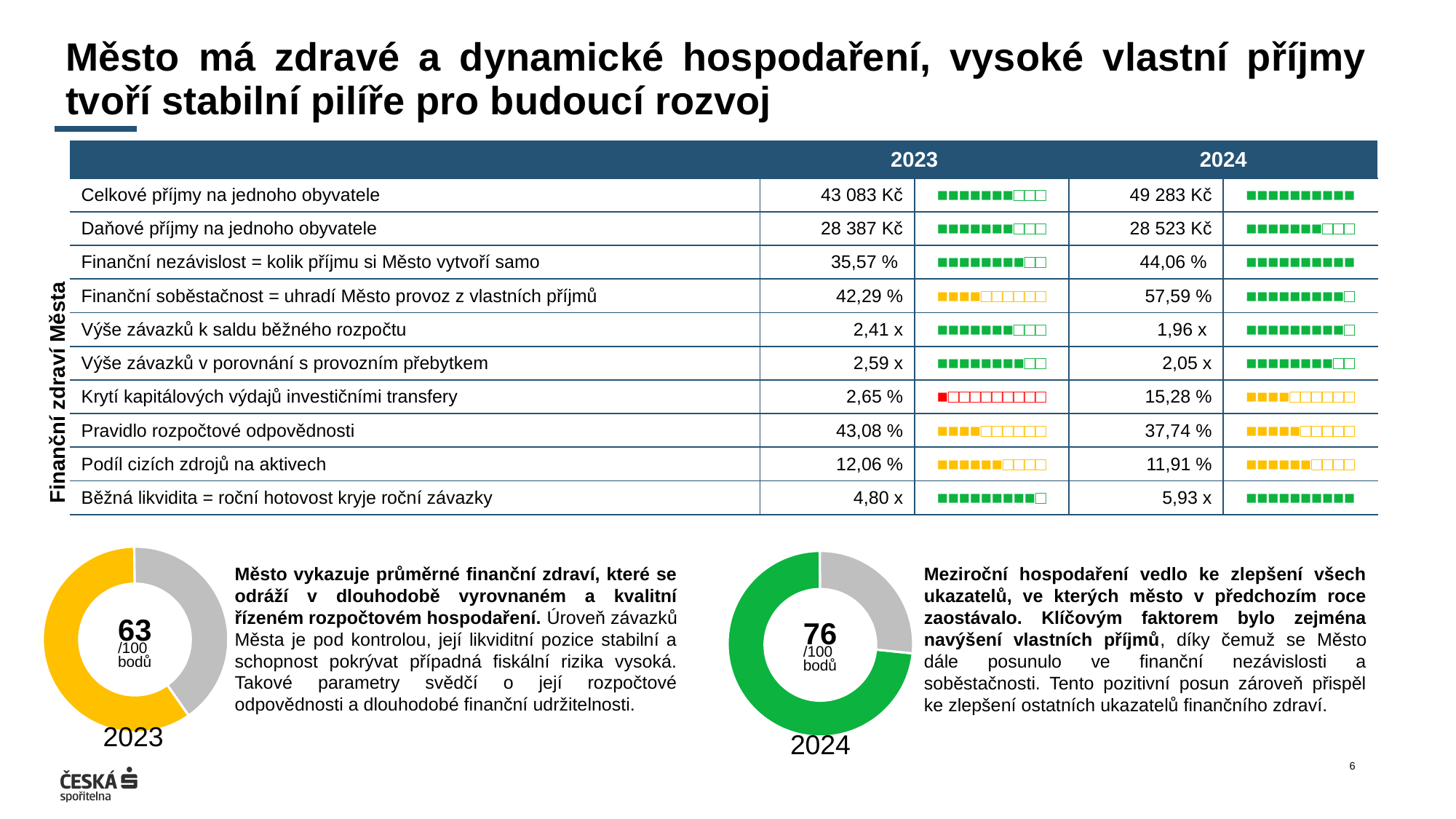
Is the score in the 2024 donut chart greater or less than 80? less How many donut charts are shown on the slide? 2 Is the score in the 2023 donut chart greater or less than 50? greater What colour is the filled portion of the 2024 donut chart? green What score is shown in the centre of the 2024 donut chart? 76 Which donut chart shows the higher score, 2023 or 2024? 2024 What score is shown in the centre of the 2023 donut chart? 63 What type of chart is used to show the 2023 and 2024 scores at the bottom of the slide? donut chart Did the overall score rise or fall from 2023 to 2024 according to the donut charts? rise Out of how many points is the score in each donut chart expressed? 100 What colour is the filled portion of the 2023 donut chart? yellow By how many points did the score increase from the 2023 donut chart to the 2024 donut chart? 13